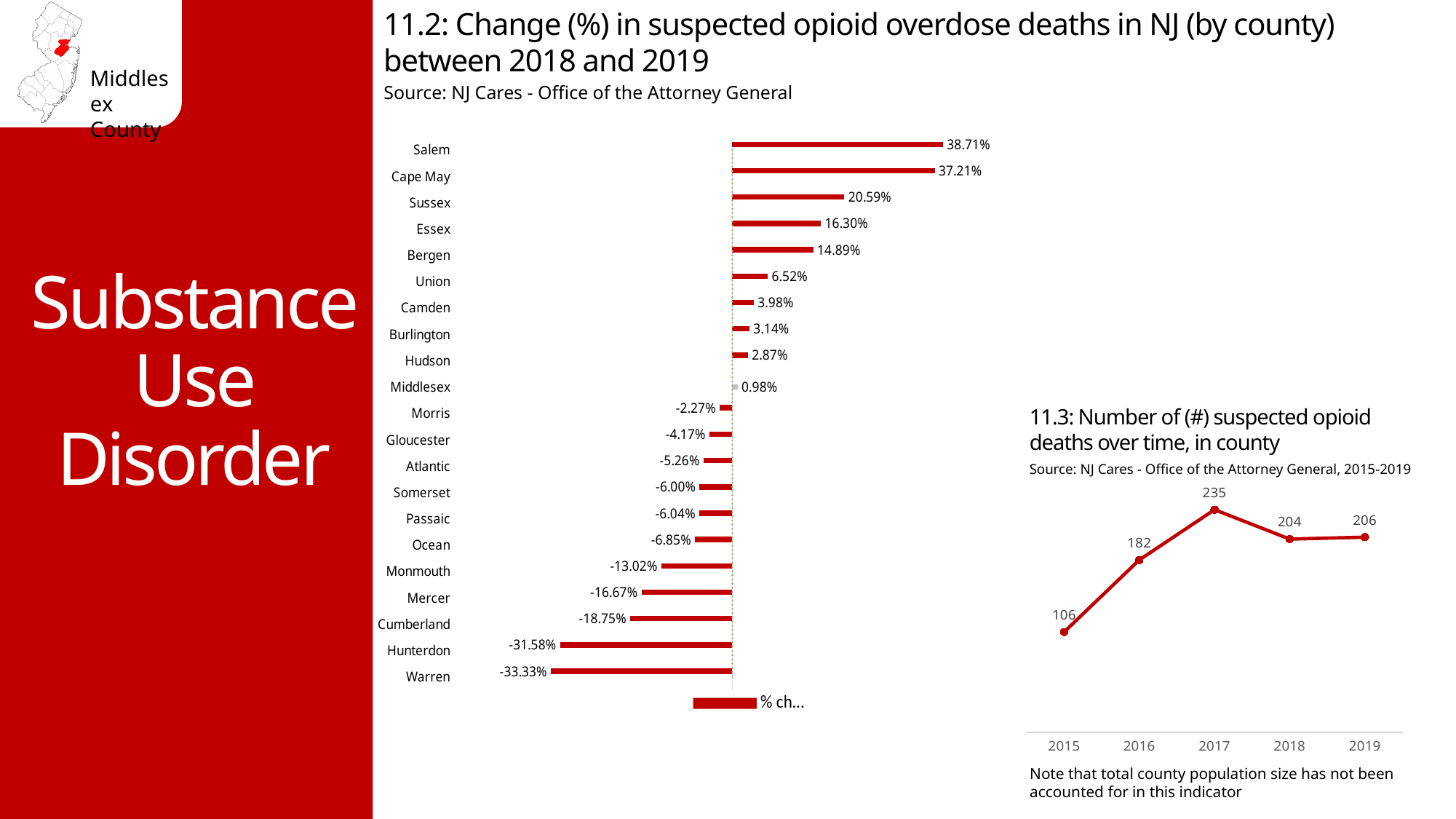
In the 11.2 chart, which county has the highest change (%) in suspected opioid overdose deaths? Salem In the 11.2 chart, how many counties are shown? 21 In the 11.3 chart, how many suspected opioid deaths were there in 2017? 235 In the 11.2 chart, which is larger, the value for Sussex or the value for Essex? Sussex In the 11.3 chart, what is the difference between the number of suspected opioid deaths in 2019 and 2015? 100 In the 11.3 chart, how many years are plotted? 5 What kind of chart is the 11.3 chart? Line chart What kind of chart is the 11.2 chart? Bar chart In the 11.3 chart, which year has the lowest number of suspected opioid deaths? 2015 In the 11.2 chart, what is the value for Hunterdon? -31.58% In the 11.2 chart, what is the change (%) in suspected opioid overdose deaths for Middlesex? 0.98% In the 11.2 chart, which county has the lowest change (%) in suspected opioid overdose deaths? Warren